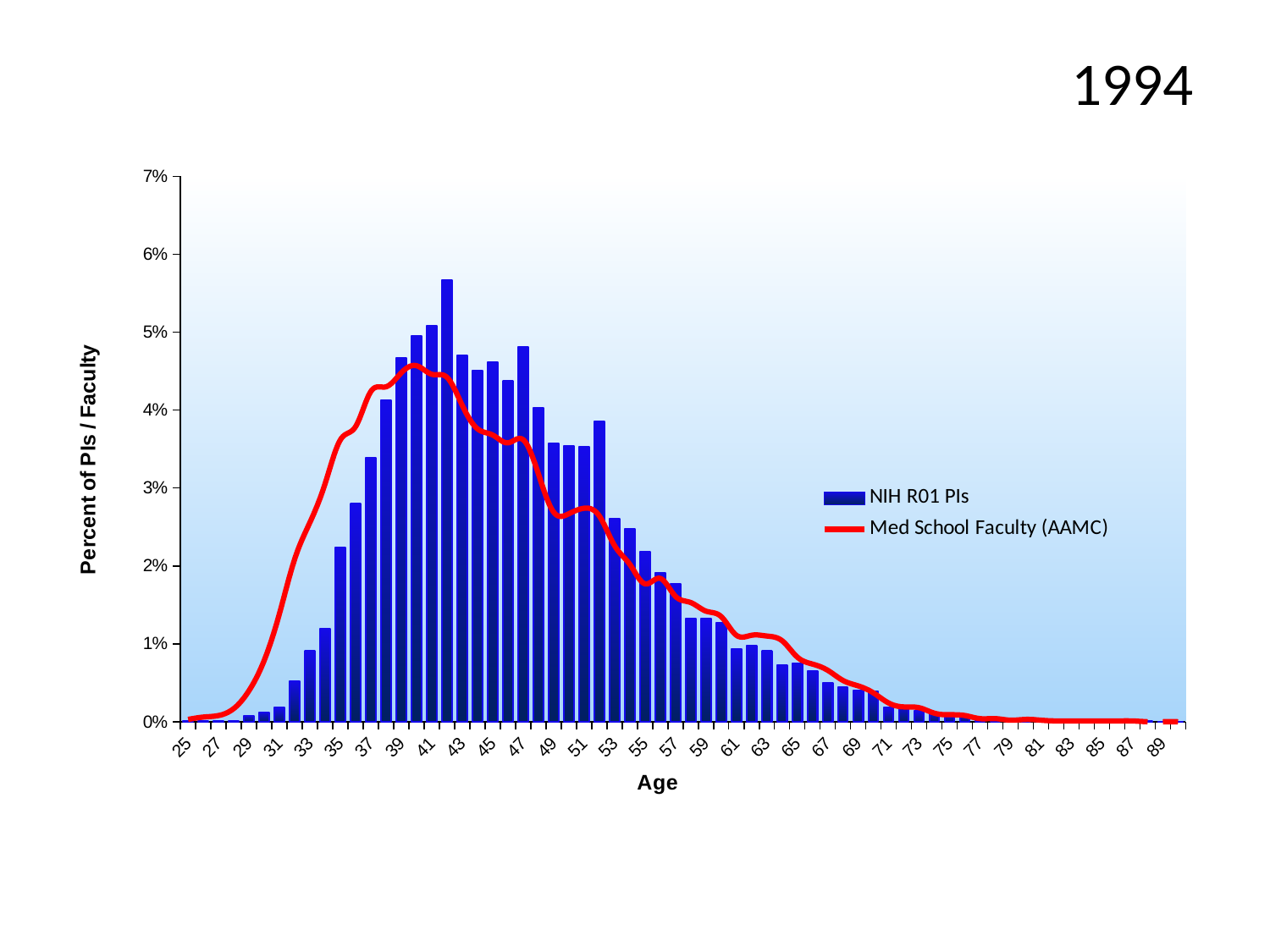
What kind of chart is shown on the slide? combination bar and line chart Do the NIH R01 PIs values generally rise or fall from age 43 to age 89? fall Is the NIH R01 PIs value at age 53 greater or less than 2%? greater Is the NIH R01 PIs value at age 43 greater or less than 5%? less Is the Med School Faculty (AAMC) value at age 29 greater or less than 1%? less At age 33, which series has the higher value, NIH R01 PIs or Med School Faculty (AAMC)? Med School Faculty (AAMC) Which series is drawn as a red line? Med School Faculty (AAMC) What is the title of the y axis? Percent of PIs / Faculty At age 47, which series has the higher value, NIH R01 PIs or Med School Faculty (AAMC)? NIH R01 PIs How many series does the legend list? 2